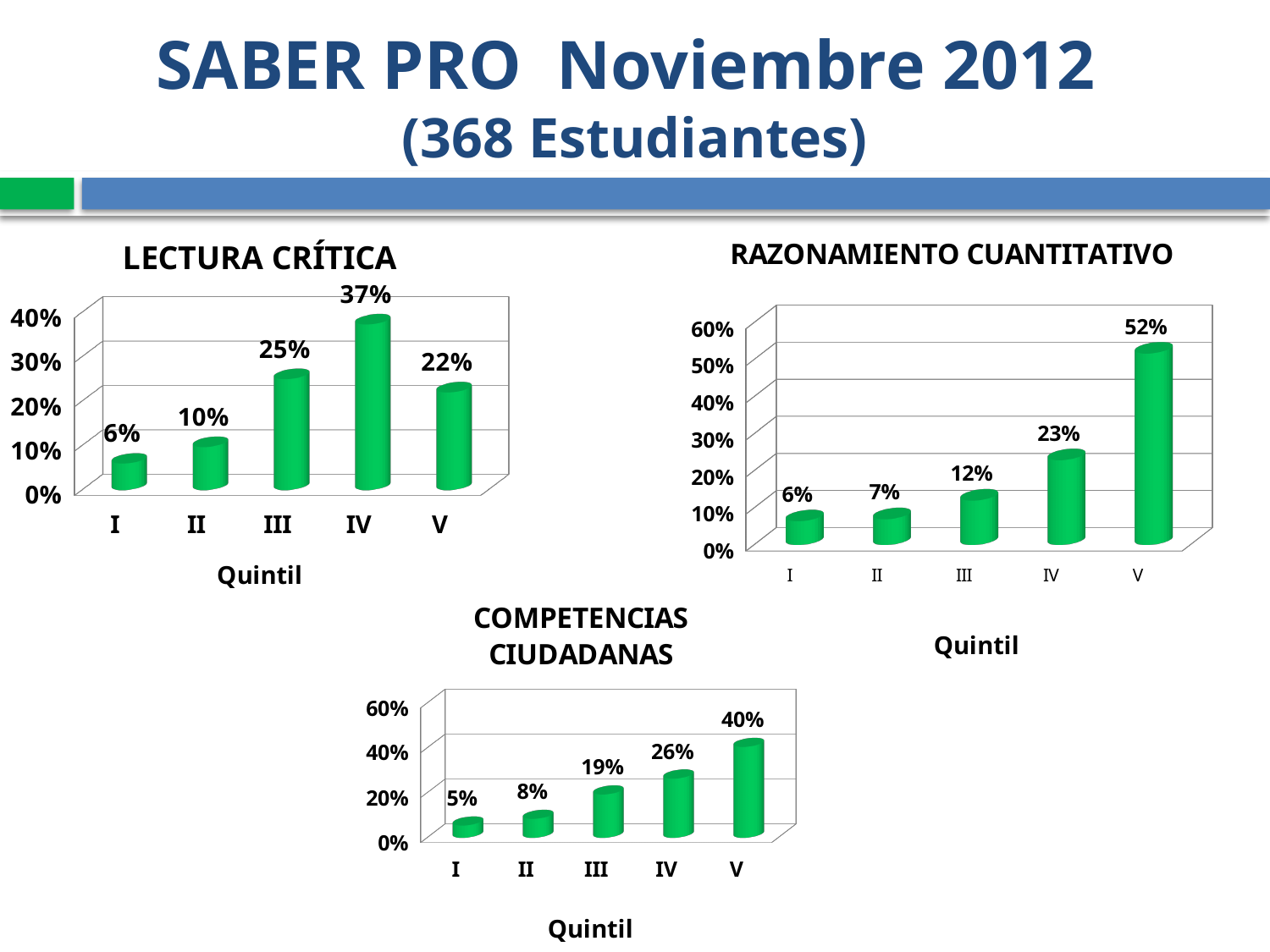
In the COMPETENCIAS CIUDADANAS chart, what is the value for quintil III? 19% In the LECTURA CRÍTICA chart, what is the value for quintil IV? 37% In the COMPETENCIAS CIUDADANAS chart, which is larger, quintil II or quintil IV? IV In the RAZONAMIENTO CUANTITATIVO chart, what is the value for quintil V? 52% How many quintil categories are shown in the COMPETENCIAS CIUDADANAS chart? 5 In the LECTURA CRÍTICA chart, what is the difference between quintil IV and quintil V? 15% In the RAZONAMIENTO CUANTITATIVO chart, do the values rise or fall from quintil I to quintil V? rise What is the x-axis label of the RAZONAMIENTO CUANTITATIVO chart? Quintil In the LECTURA CRÍTICA chart, which quintil has the highest value? IV In the RAZONAMIENTO CUANTITATIVO chart, which quintil has the lowest value? I In the COMPETENCIAS CIUDADANAS chart, what is the difference between quintil V and quintil I? 35% What kind of chart is the LECTURA CRÍTICA chart? bar chart